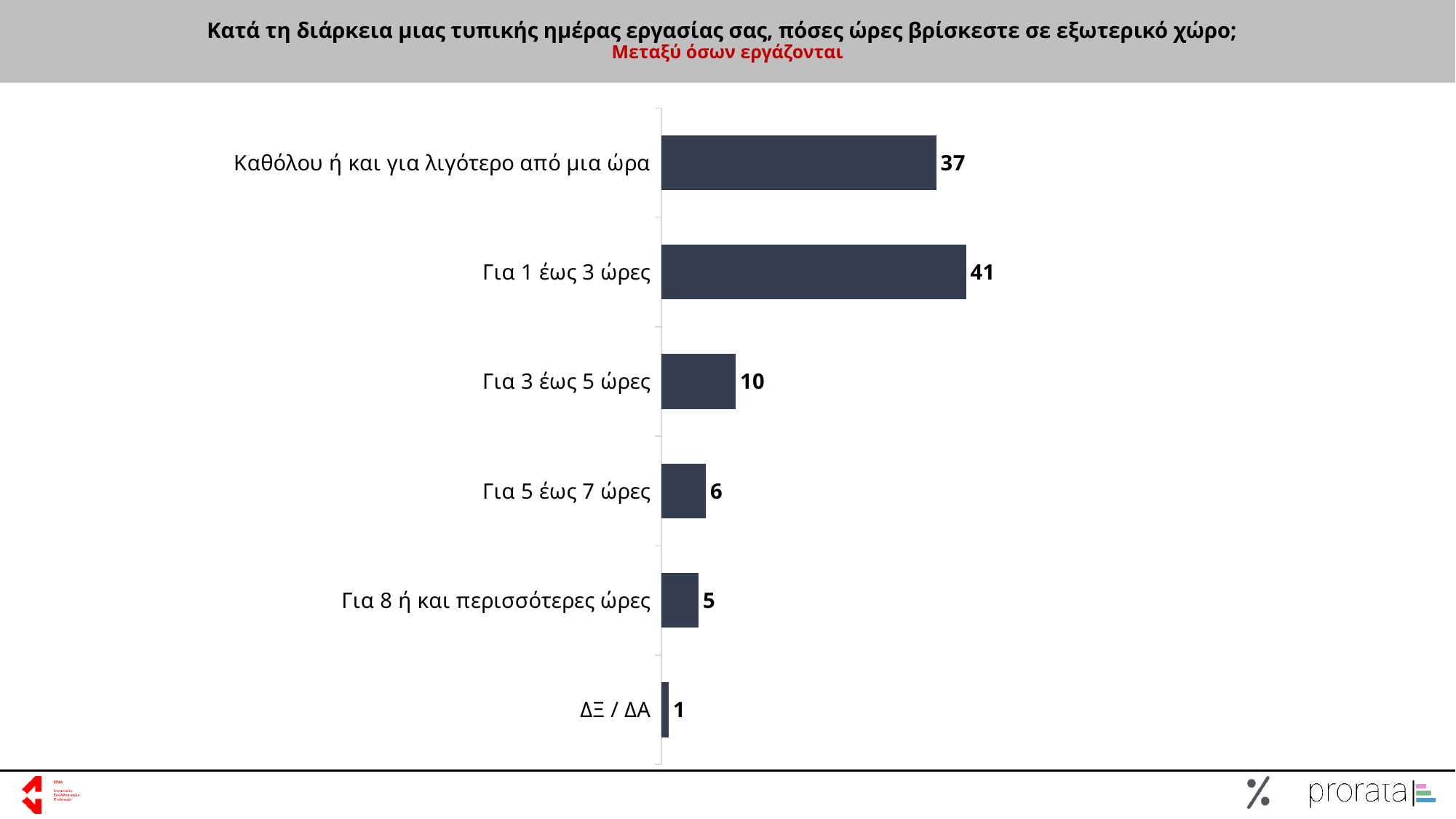
What is the value for "Για 3 έως 5 ώρες"? 10 What kind of chart is shown on the slide? Bar chart How many categories are shown in the chart? 6 Which is larger, the value for "Για 5 έως 7 ώρες" or for "Για 8 ή και περισσότερες ώρες"? Για 5 έως 7 ώρες What is the difference between the values for "Για 3 έως 5 ώρες" and "Για 5 έως 7 ώρες"? 4 What is the value for "Καθόλου ή και για λιγότερο από μια ώρα"? 37 Which category has the lowest value? ΔΞ / ΔΑ What is the value for "Για 8 ή και περισσότερες ώρες"? 5 What is the difference between the values for "Για 1 έως 3 ώρες" and "Καθόλου ή και για λιγότερο από μια ώρα"? 4 Which category has the highest value? Για 1 έως 3 ώρες What is the value for "Για 1 έως 3 ώρες"? 41 What is the red subtitle text under the chart title? Μεταξύ όσων εργάζονται